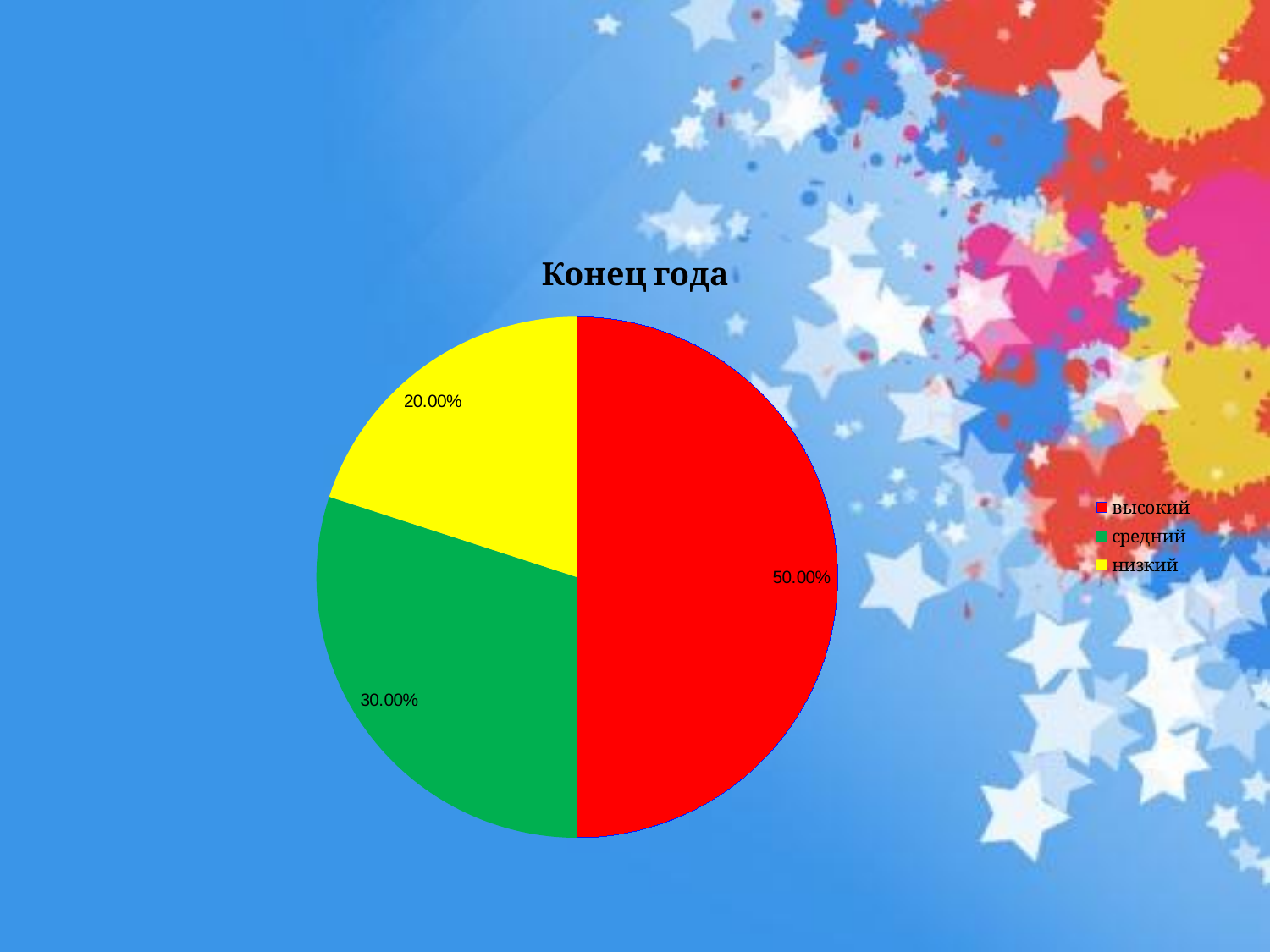
What share of the pie does the низкий slice take? 20.00% How many slices does the pie chart have? 3 Which category has the smallest slice? низкий Which category has the largest slice? высокий Which is larger, the средний slice or the низкий slice? средний What percentage does the средний slice show? 30.00% What is the difference between the высокий and средний slices? 20.00% What kind of chart is shown on the slide? pie chart What percentage does the высокий slice show? 50.00% What percentage does the низкий slice show? 20.00% What colour is the средний slice? green What is the title of the chart? Конец года